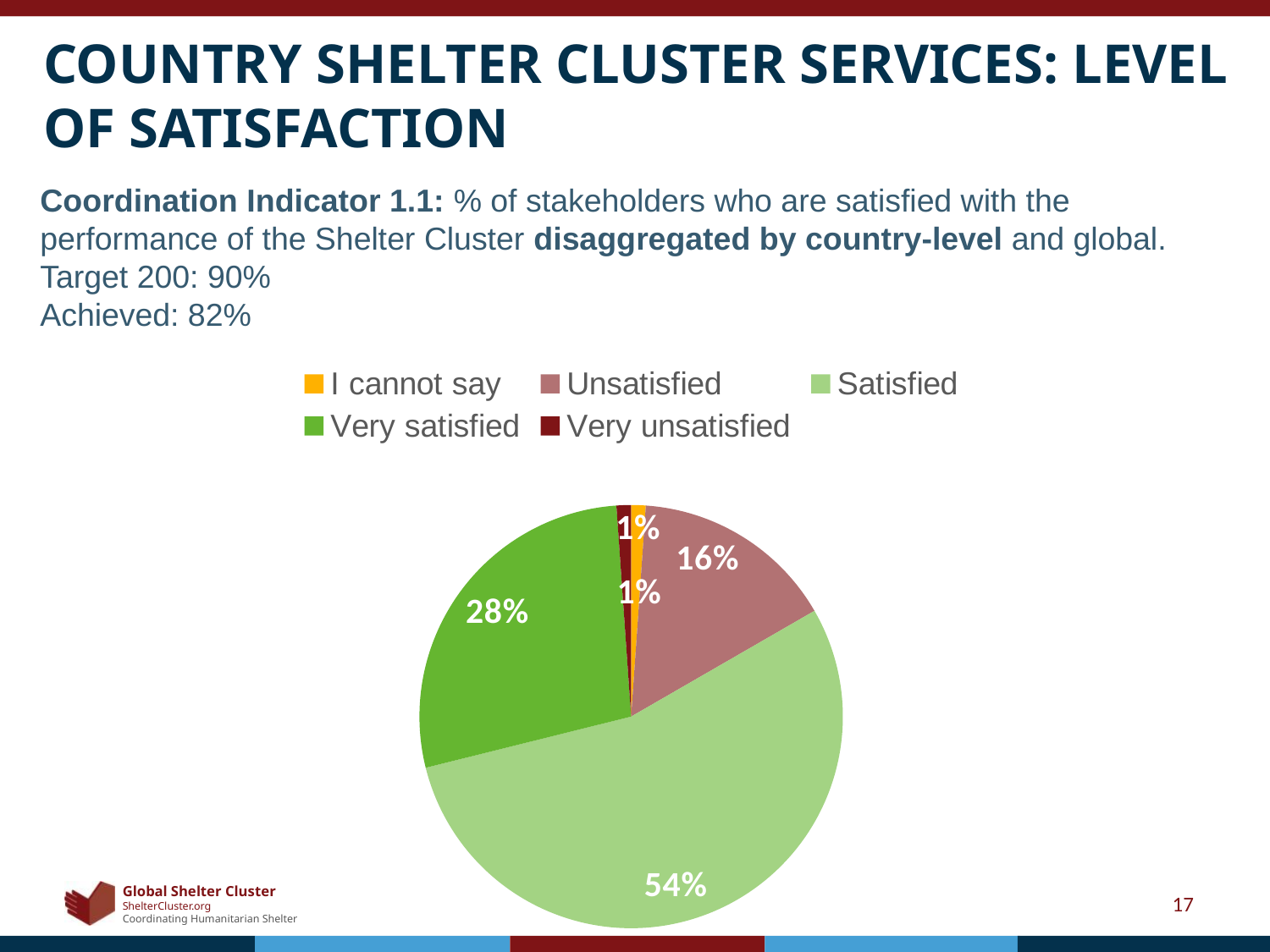
What percentage is shown for the Very unsatisfied slice? 1% Which category has the largest slice of the pie chart? Satisfied What type of chart is shown on the slide? Pie chart How many entries does the chart legend list? 5 Which slice is larger, Very satisfied or Unsatisfied? Very satisfied What is the combined share of the Satisfied and Very satisfied slices? 82% What percentage of the pie chart is labelled Satisfied? 54% What percentage is shown for the Unsatisfied slice? 16% What percentage is shown for the I cannot say slice? 1% By how many percentage points does the Satisfied slice exceed the Very satisfied slice? 26 How many slices does the pie chart have? 5 What share of the pie chart does the Very satisfied slice represent? 28%